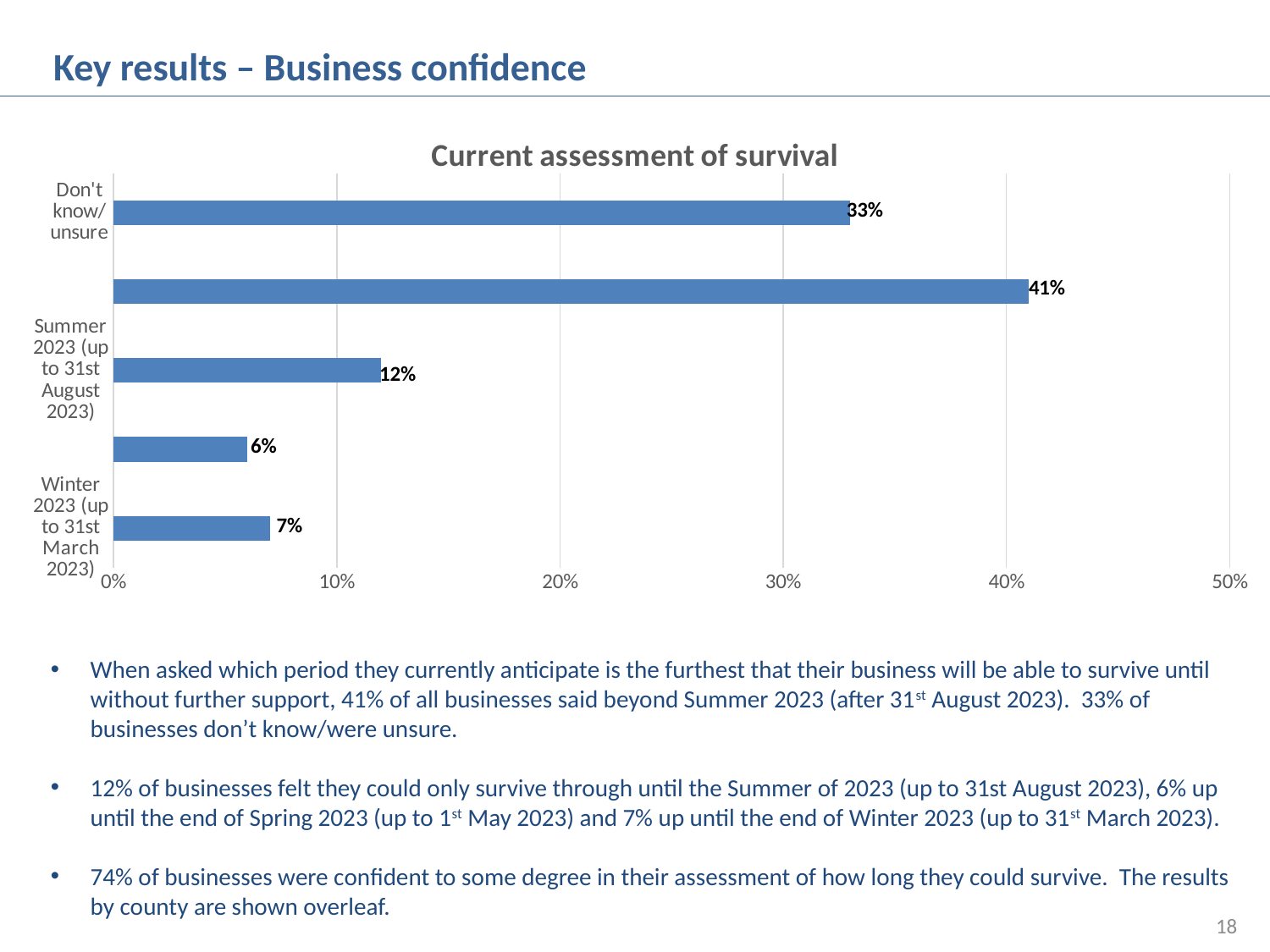
What is the value for Winter 2023 (up to 31st March 2023)? 7% What is the difference between the values for Summer 2023 (up to 31st August 2023) and Winter 2023 (up to 31st March 2023)? 5 percentage points What is the value for Summer 2023 (up to 31st August 2023)? 12% What is the title of the chart? Current assessment of survival What is the difference between the values for Don't know/unsure and Summer 2023 (up to 31st August 2023)? 21 percentage points What is the highest value shown in the chart? 41% What is the lowest value shown in the chart? 6% What type of chart is shown on the slide? Bar chart What is the value for Don't know/unsure? 33% How many bars are plotted in the chart? 5 Is the value for Don't know/unsure greater or less than 30%? greater Which has a larger value, Summer 2023 (up to 31st August 2023) or Winter 2023 (up to 31st March 2023)? Summer 2023 (up to 31st August 2023)